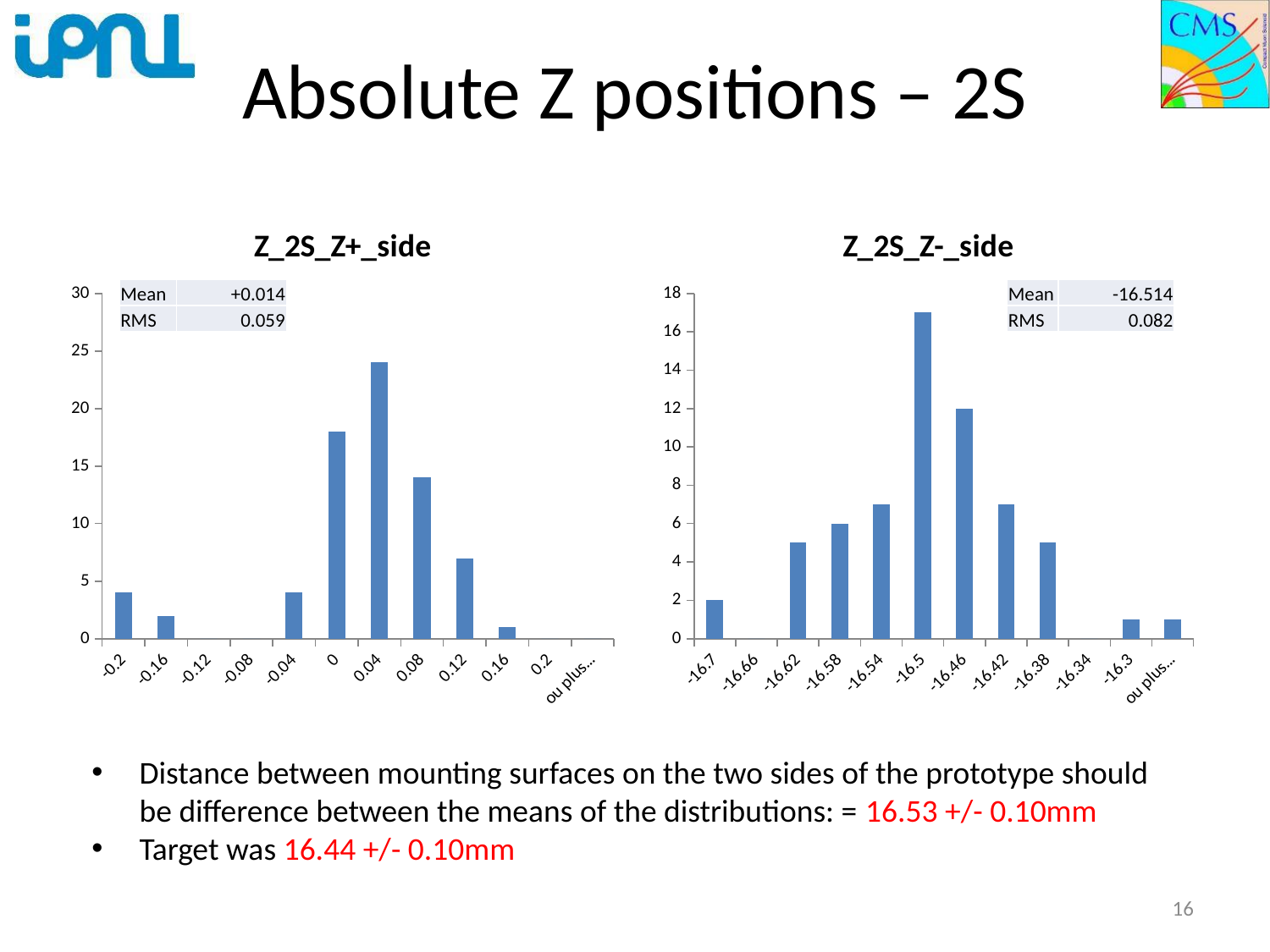
In the Z_2S_Z-_side chart, is the value for -16.5 greater or less than 16? greater How many categories are shown on the x axis of the Z_2S_Z+_side chart? 12 What Mean value is printed on the Z_2S_Z-_side chart? -16.514 What Mean value is printed on the Z_2S_Z+_side chart? +0.014 In the Z_2S_Z-_side chart, which category has the highest bar? -16.5 In the Z_2S_Z+_side chart, is the value for 0.04 greater or less than 20? greater What type of chart is Z_2S_Z+_side? bar chart In the Z_2S_Z+_side chart, which is larger, the bar for 0 or the bar for 0.12? 0 In the Z_2S_Z+_side chart, which category has the highest bar? 0.04 In the Z_2S_Z-_side chart, what is the value for -16.7? 2 In the Z_2S_Z+_side chart, is the value for 0.08 greater or less than 15? less In the Z_2S_Z-_side chart, what is the value for -16.46? 12